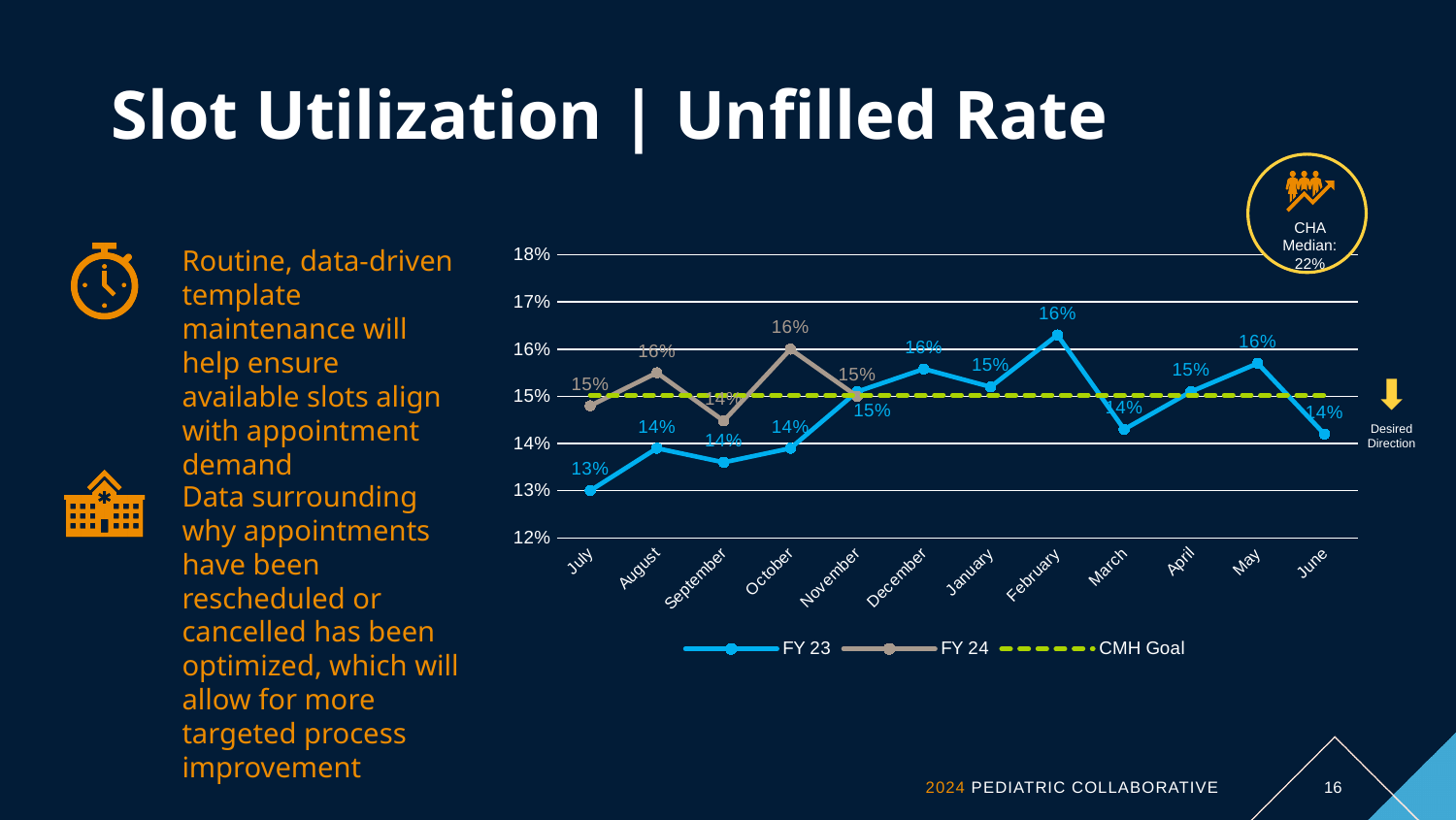
How many months are shown along the x axis of the chart? 12 What is the CHA Median value shown on the slide? 22% What is the FY 24 unfilled rate for September? 14% What is the FY 23 unfilled rate for February? 16% What is the FY 23 unfilled rate for July? 13% Which month has the lowest FY 23 unfilled rate? July In August, which series has the higher unfilled rate, FY 23 or FY 24? FY 24 What kind of chart is shown on the slide? line chart At what level is the CMH Goal line drawn? 15% How many series does the chart legend list? 3 What is the difference between the FY 23 unfilled rate in February and in July? 3% What is the FY 24 unfilled rate for October? 16%